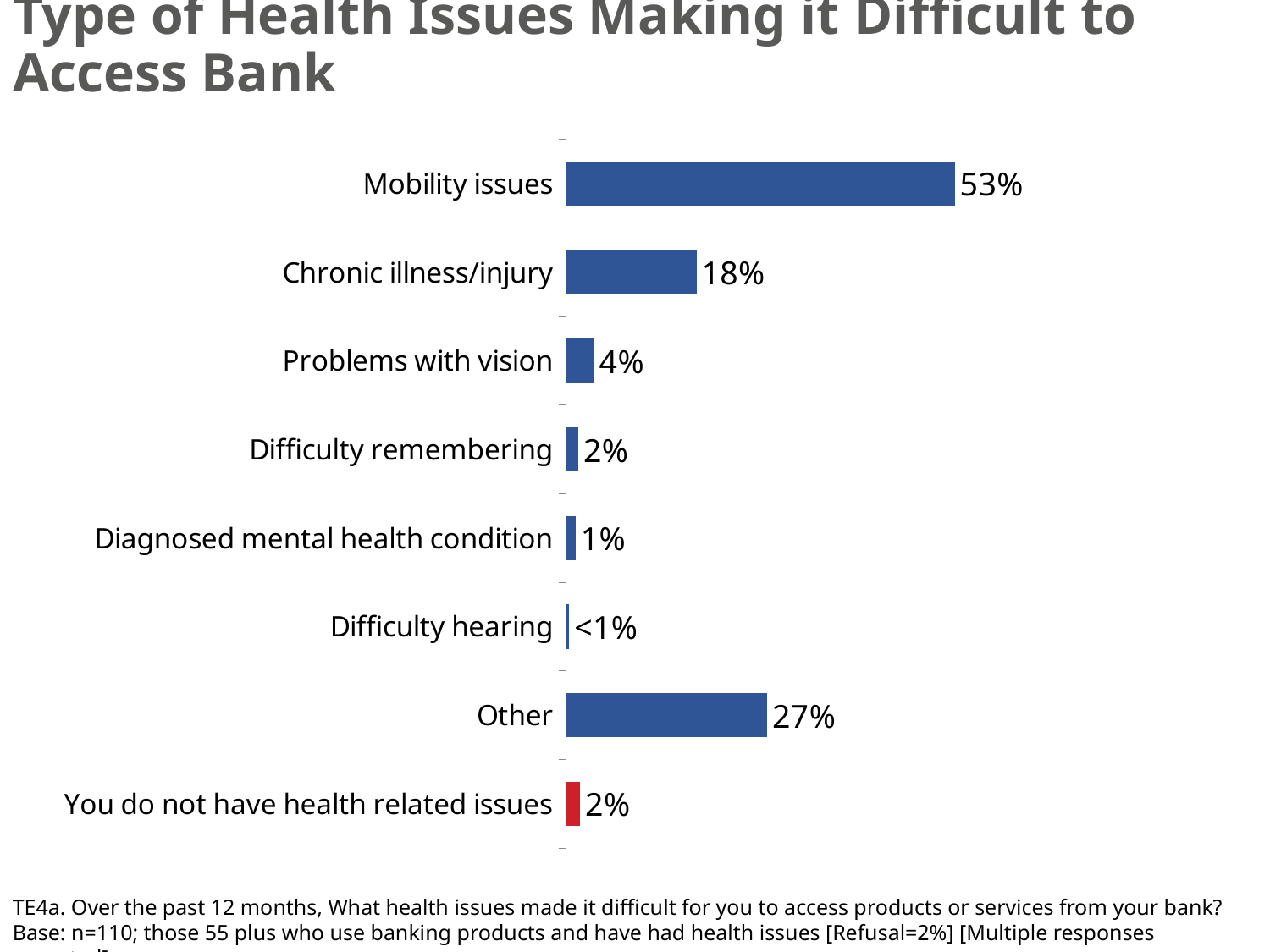
Which health issue has the highest percentage? Mobility issues What percentage is shown for Chronic illness/injury? 18% What kind of chart is shown on the slide? Bar chart Which category has the lowest percentage? Difficulty hearing How many categories are shown in the chart? 8 What value is shown for Difficulty hearing? <1% What percentage is shown for Other? 27% What percentage is shown for Mobility issues? 53% Which category's bar is coloured red rather than blue? You do not have health related issues What is the difference between the percentages for Problems with vision and Difficulty remembering? 2% Which is larger, the value for Other or the value for Chronic illness/injury? Other What is the difference between the percentages for Mobility issues and Chronic illness/injury? 35%